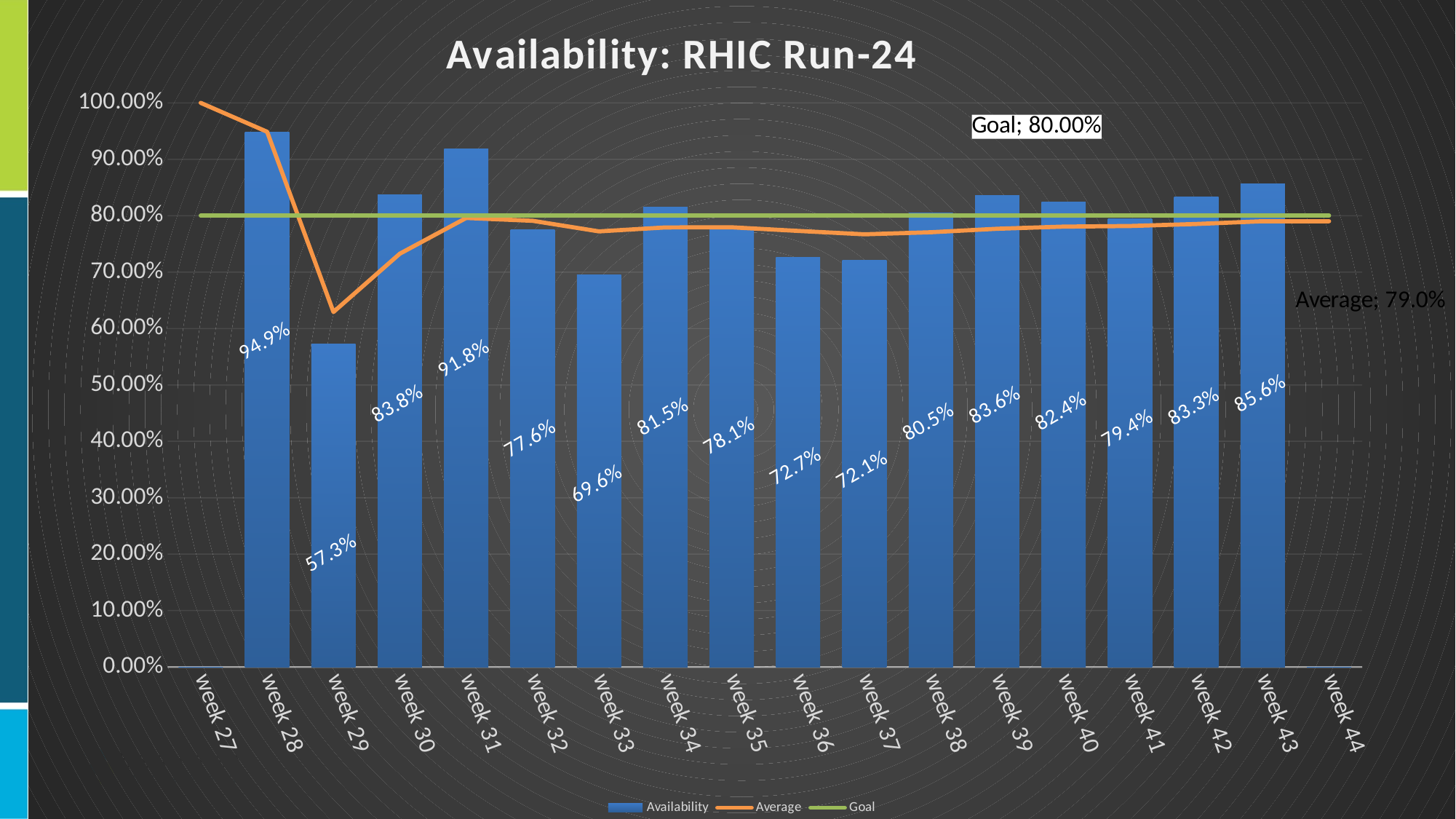
What is the availability value for week 28? 94.9% Which week has the highest availability bar? week 28 Which has the higher availability, week 39 or week 40? week 39 What is the difference between the availability for week 31 and week 30? 8.0 percentage points Is the availability for week 36 greater or less than 80%? less Among the weeks with a plotted availability bar, which week has the lowest value? week 29 What is the availability value for week 43? 85.6% What is the difference between the availability for week 28 and week 29? 37.6 percentage points What goal value is labeled on the chart? 80.00% How many week categories are shown on the x axis? 18 How many series does the legend list? 3 What is the availability value for week 33? 69.6%